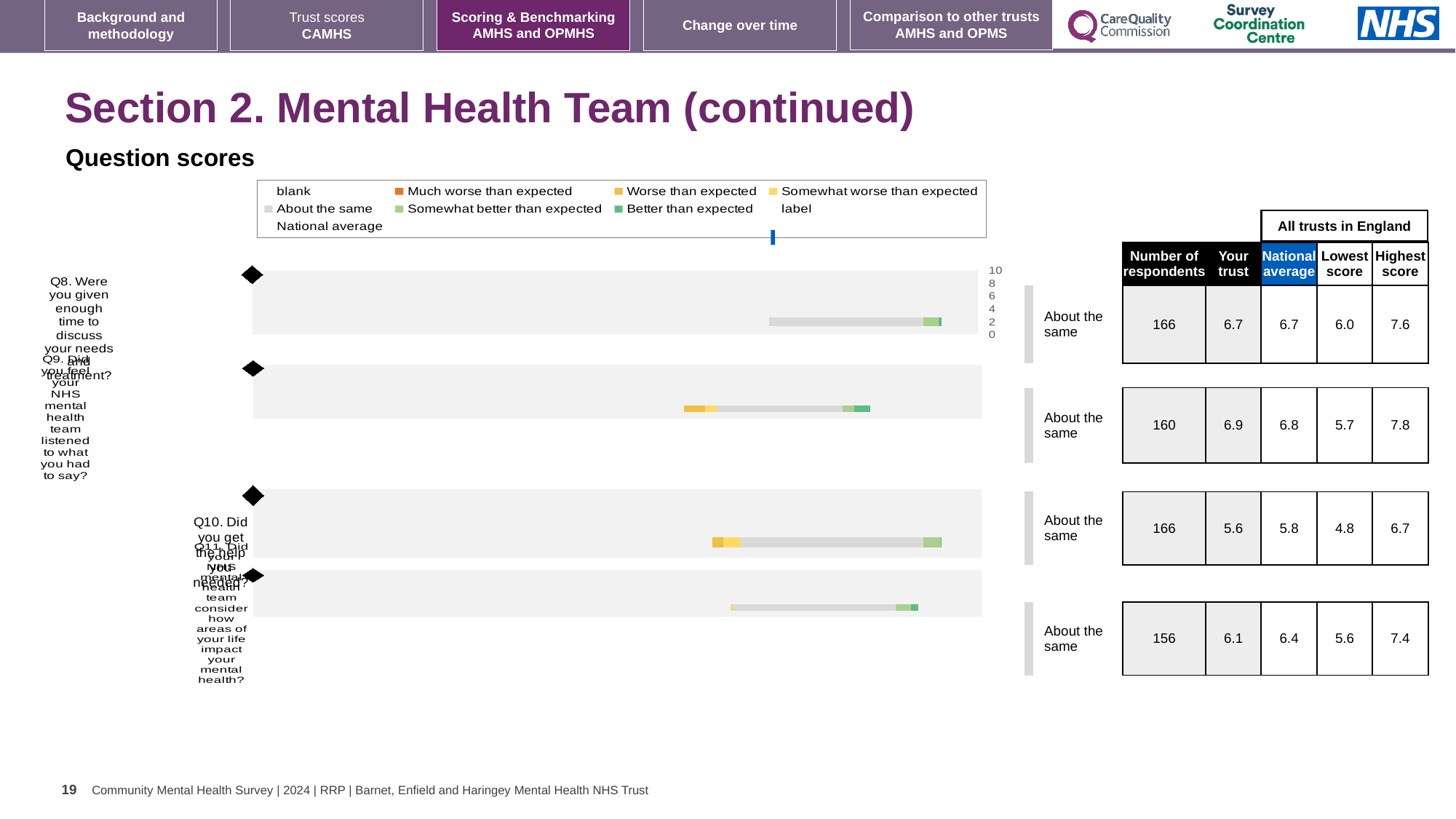
What is the highest tick value shown on the score axis of the charts? 10 In the table, what is the lowest score among all trusts in England for Q11? 5.6 In the table next to the charts, how many respondents answered Q8? 166 What kind of chart is used to show the question scores on this slide? bar chart For Q8, what is the difference between the highest score and the lowest score in the table? 1.6 How many survey questions (Q8 to Q11) are charted on this slide? 4 For Q10, which is larger: the 'Your trust' score or the national average? National average In the table, what is the 'Your trust' score for Q9? 6.9 Which question has the lowest 'Your trust' score in the table? Q10 In the table, what is the national average for Q10? 5.8 In the chart legend, what colour represents 'Much worse than expected'? orange Which question has the highest 'Your trust' score in the table? Q9